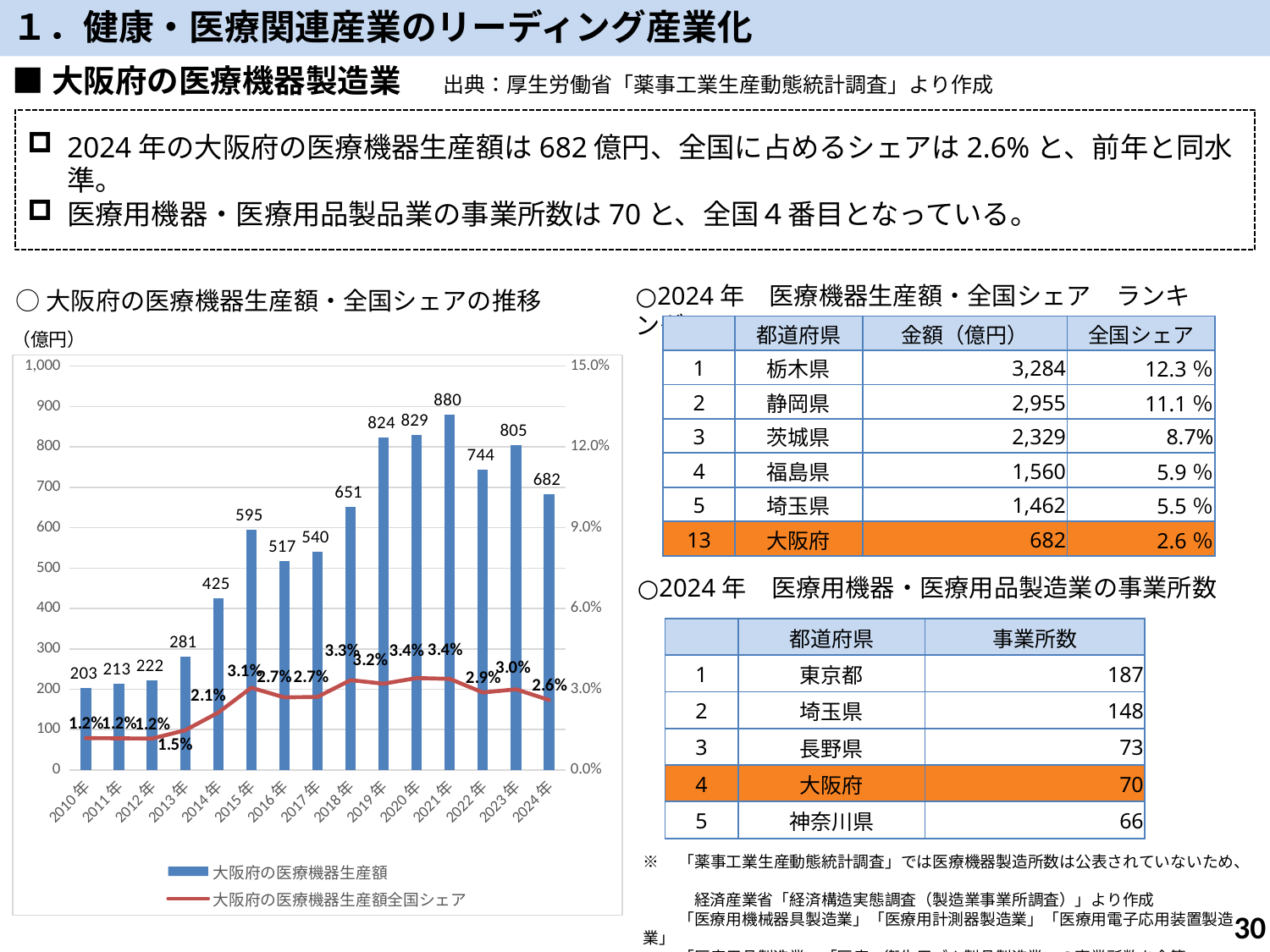
In the chart 大阪府の医療機器生産額・全国シェアの推移, which year has the lowest 大阪府の医療機器生産額? 2010年 What kind of chart is used for 大阪府の医療機器生産額 in the chart 大阪府の医療機器生産額・全国シェアの推移? bar chart In the chart 大阪府の医療機器生産額・全国シェアの推移, what is the value of 大阪府の医療機器生産額 for 2024年? 682 In the chart 大阪府の医療機器生産額・全国シェアの推移, is the 大阪府の医療機器生産額 for 2018年 greater or less than 600? greater In the chart 大阪府の医療機器生産額・全国シェアの推移, what is the unit shown above the left axis? 億円 In the chart 大阪府の医療機器生産額・全国シェアの推移, which is larger, the 大阪府の医療機器生産額 for 2015年 or for 2016年? 2015年 In the chart 大阪府の医療機器生産額・全国シェアの推移, which year has the highest 大阪府の医療機器生産額? 2021年 How many series does the legend of the chart 大阪府の医療機器生産額・全国シェアの推移 list? 2 In the chart 大阪府の医療機器生産額・全国シェアの推移, what is the 全国シェア value for 2021年? 3.4% In the chart 大阪府の医療機器生産額・全国シェアの推移, what is the difference in 大阪府の医療機器生産額 between 2021年 and 2024年? 198 How many years are shown on the x axis of the chart 大阪府の医療機器生産額・全国シェアの推移? 15 In the chart 大阪府の医療機器生産額・全国シェアの推移, what is the value of 大阪府の医療機器生産額 for 2014年? 425